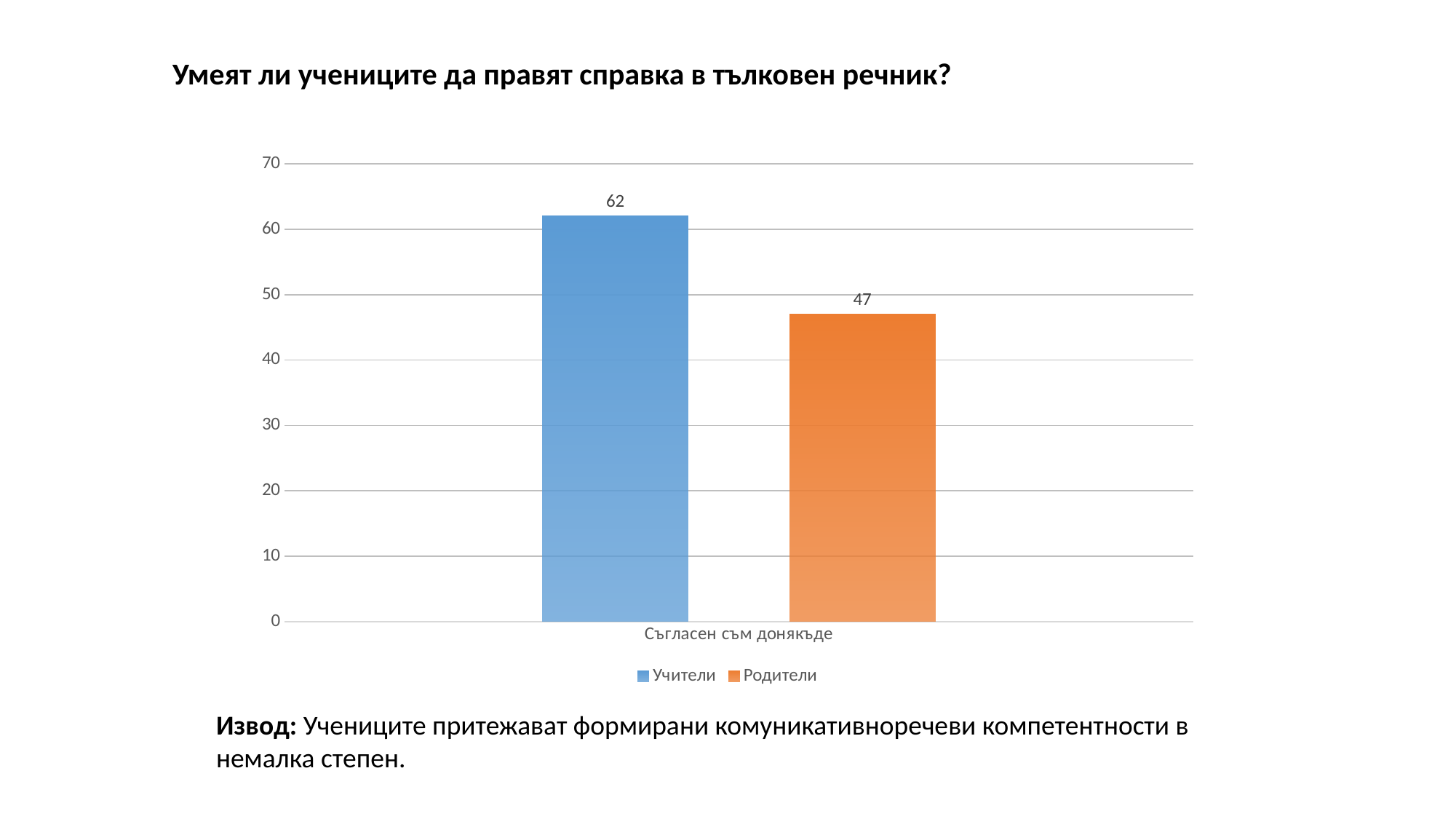
Which series has the higher value: Учители or Родители? Учители What is the title of the chart? Умеят ли учениците да правят справка в тълковен речник? What is the value for Учители in the category Съгласен съм донякъде? 62 Is the value for Родители greater or less than 50? less Is the value for Учители greater or less than 60? greater How many categories are shown on the x axis? 1 What is the value for Родители in the category Съгласен съм донякъде? 47 What kind of chart is shown on the slide? bar chart How many series does the legend list? 2 What is the difference between the values for Учители and Родители? 15 Which series has the lowest value on the chart? Родители What colour is the bar for Родители? orange